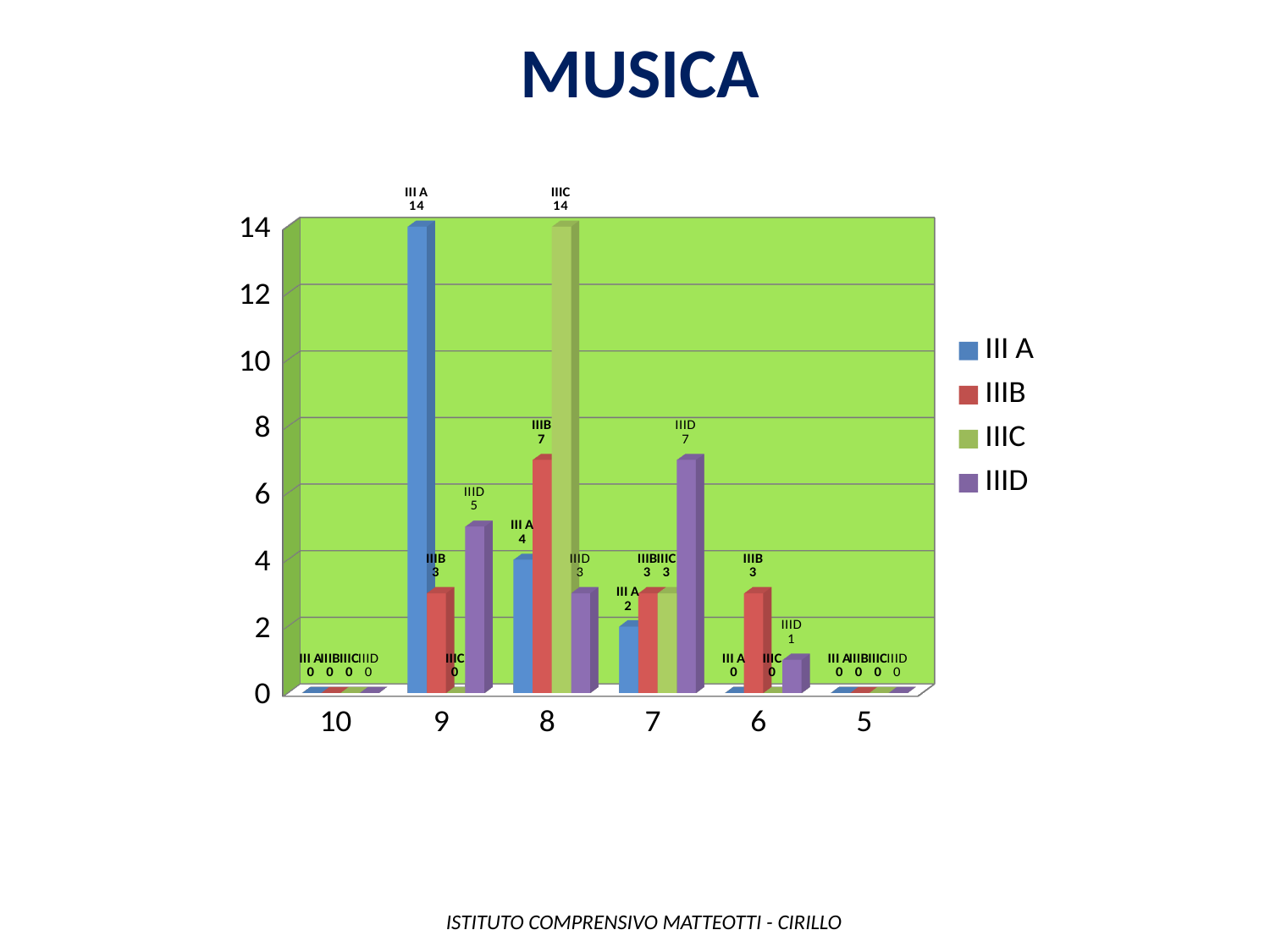
What is the value for IIIB at category 6? 3 What is the value for III A at category 9? 14 What is the title of the chart? MUSICA What is the value for IIID at category 7? 7 What kind of chart is shown on the slide? bar chart What is the value for IIIC at category 8? 14 Which category has the highest value for IIID? 7 Which category has the highest value for IIIB? 8 How many categories are shown on the x axis? 6 Which is larger at category 8: the value for IIIB or the value for IIID? IIIB What is the difference between the III A value at category 9 and the III A value at category 8? 10 How many series does the legend list? 4